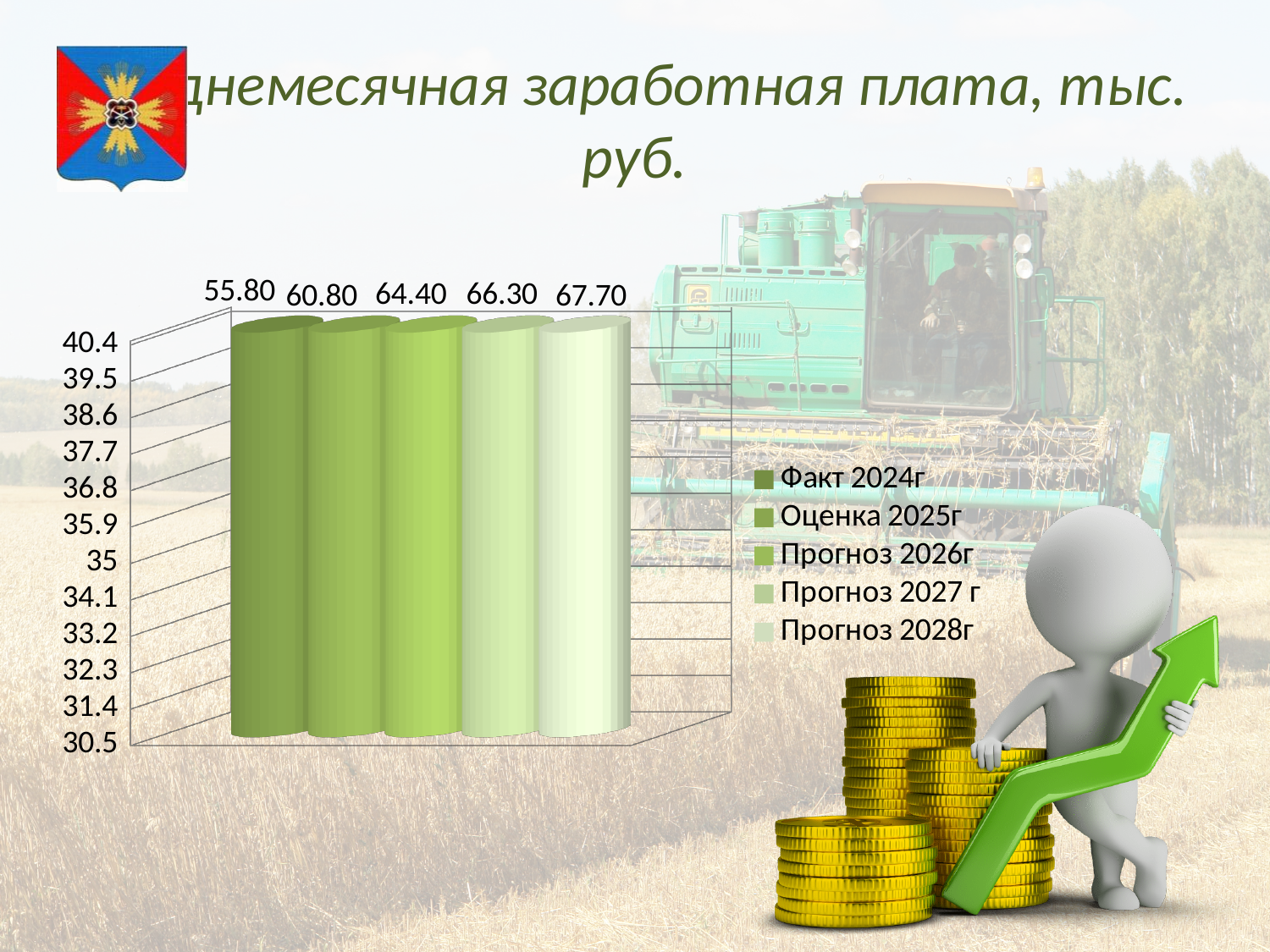
Which is larger, the value for Оценка 2025г or the value for Прогноз 2026г? Прогноз 2026г What is the value for Оценка 2025г? 60.80 What is the value for Прогноз 2027 г? 66.30 Do the values rise or fall from Факт 2024г to Прогноз 2028г? Rise Which series has the highest value? Прогноз 2028г What is the difference between the values for Прогноз 2028г and Факт 2024г? 11.90 What is the value for Прогноз 2026г? 64.40 What kind of chart is shown on the slide? Bar chart How many series does the legend list? 5 What is the value for Факт 2024г? 55.80 Which series has the lowest value? Факт 2024г What is the value for Прогноз 2028г? 67.70